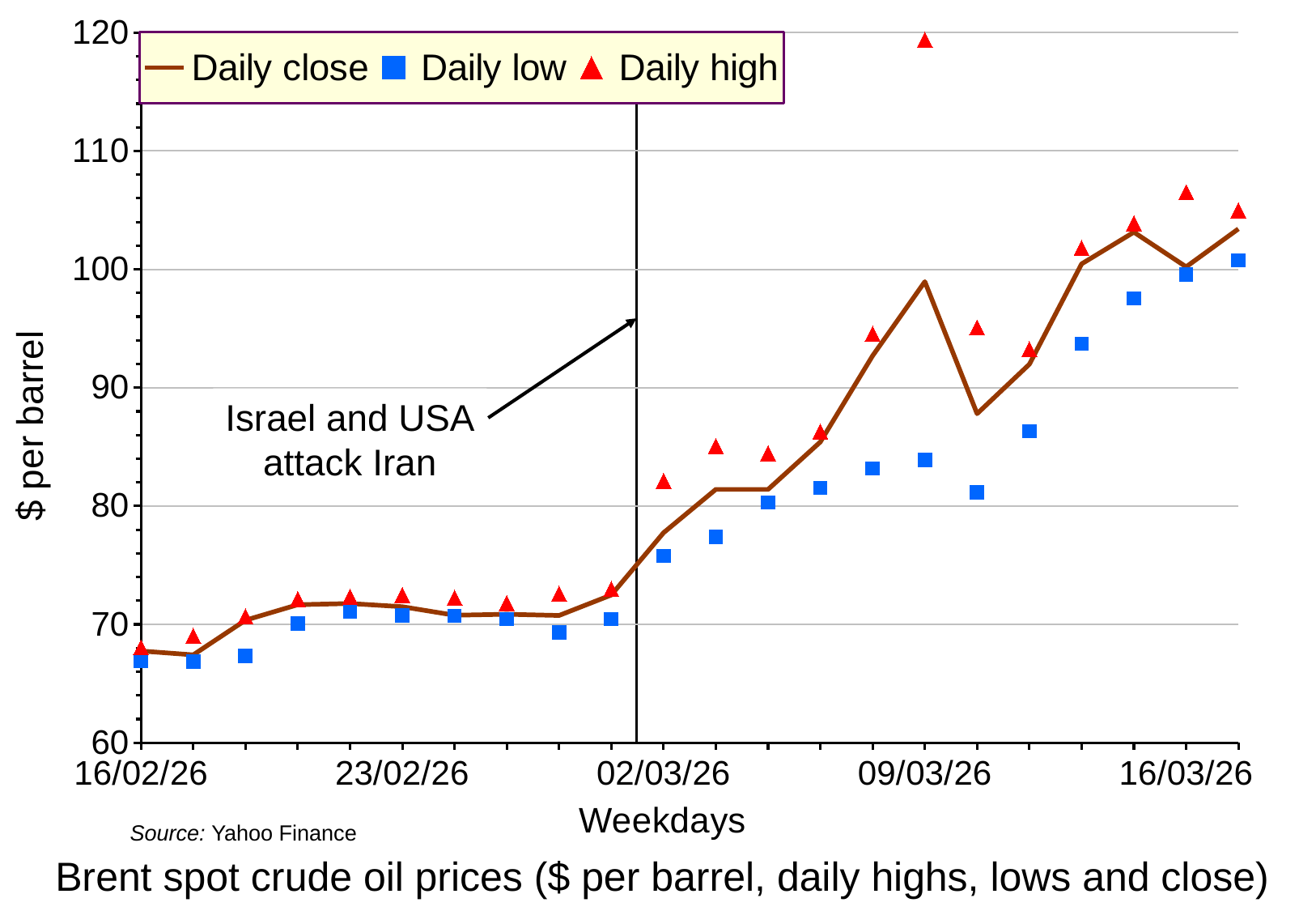
Is the Daily low value on 23/02/26 greater or less than 80? less Which is larger, the Daily close on 16/03/26 or the Daily close on 02/03/26? 16/03/26 Do the Daily close values generally rise or fall from 16/02/26 to the end of the chart? rise Is the Daily close value on 16/02/26 greater or less than 70? less How many series does the legend list? 3 What are the three series named in the legend? Daily close, Daily low, Daily high On which date is the Daily high at its highest? 09/03/26 What kind of chart is shown on the slide? line chart What event does the annotation with the vertical line mark? Israel and USA attack Iran Is the Daily high value on 09/03/26 greater or less than 110? greater